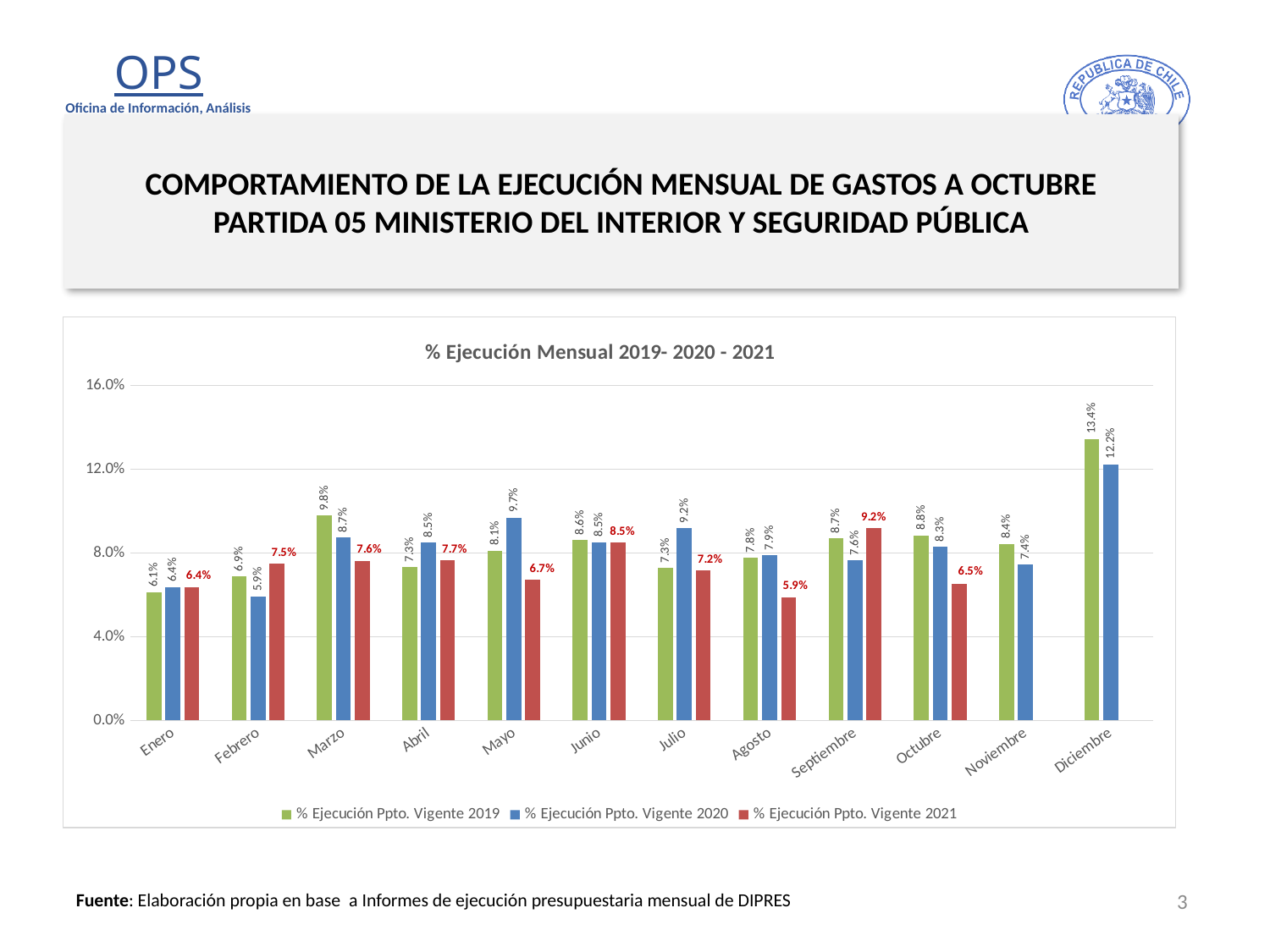
What kind of chart is shown on the slide? Bar chart What is the value for Febrero in the % Ejecución Ppto. Vigente 2020 series? 5.9% What is the difference between the 2019 and 2021 values for Marzo? 2.2 percentage points How many series does the legend list? 3 Which month has the lowest value in the % Ejecución Ppto. Vigente 2019 series? Enero Which month has the highest value in the % Ejecución Ppto. Vigente 2021 series? Septiembre Which month has the lowest value in the % Ejecución Ppto. Vigente 2021 series? Agosto How many months are shown on the x axis? 12 What is the value for Diciembre in the % Ejecución Ppto. Vigente 2019 series? 13.4% For Mayo, which series has the larger value: 2019 or 2020? 2020 Is the value for Diciembre in the 2019 series greater or less than 12.0%? greater What is the value for Septiembre in the % Ejecución Ppto. Vigente 2021 series? 9.2%